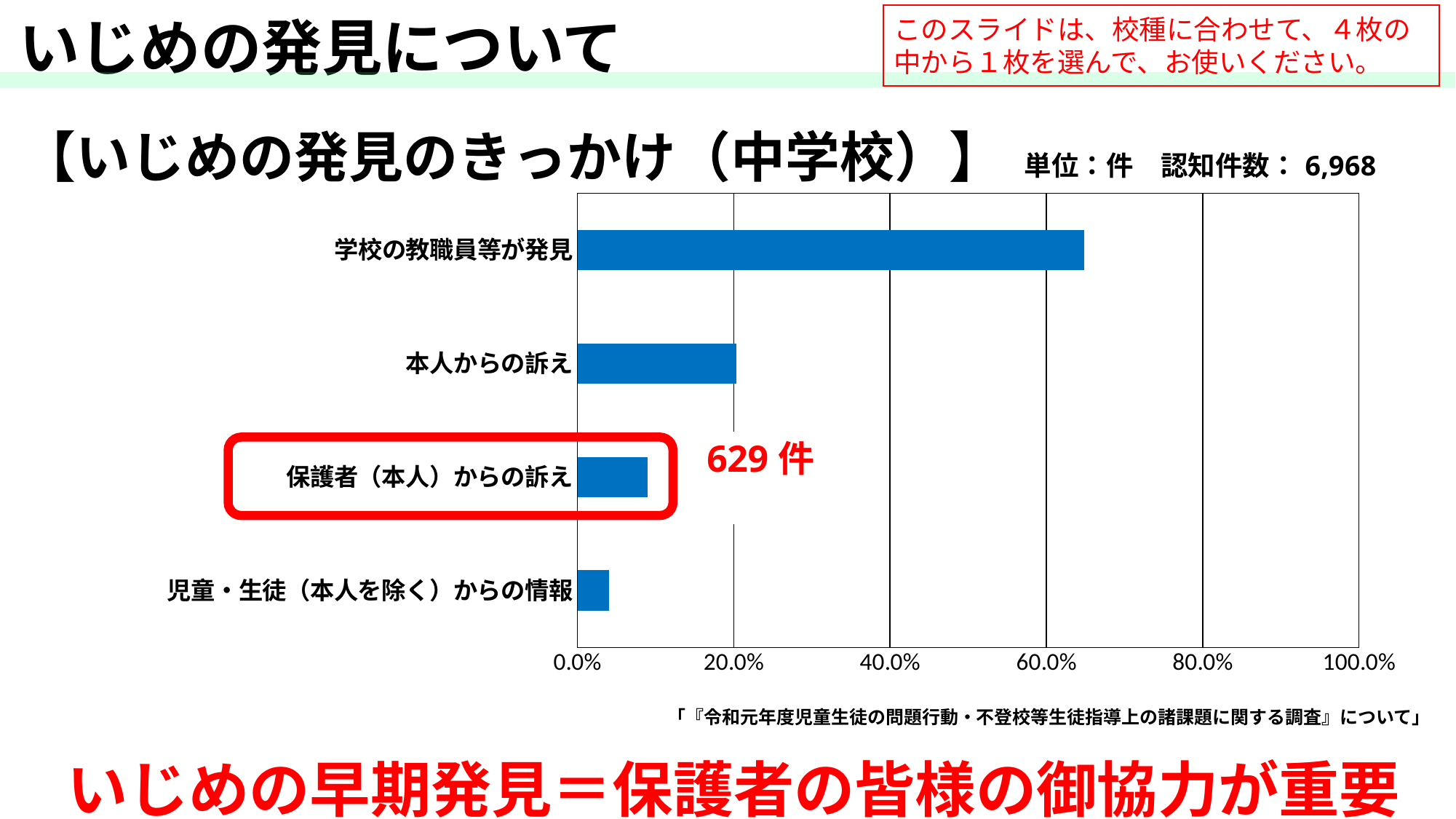
Is the value for 保護者（本人）からの訴え greater or less than 20.0%? less How many categories are plotted in the chart? 4 Is the value for 学校の教職員等が発見 greater or less than 60.0%? greater Which category has the highest value in the chart? 学校の教職員等が発見 What is the title of the chart? いじめの発見のきっかけ（中学校） Is the value for 児童・生徒（本人を除く）からの情報 greater or less than 20.0%? less How many cases (件) are annotated next to the bar for 保護者（本人）からの訴え? 629 件 Which is larger, the value for 本人からの訴え or the value for 保護者（本人）からの訴え? 本人からの訴え Which category has the lowest value in the chart? 児童・生徒（本人を除く）からの情報 What kind of chart is shown on the slide? bar chart What is the 認知件数 (total recognized cases) stated above the chart? 6,968